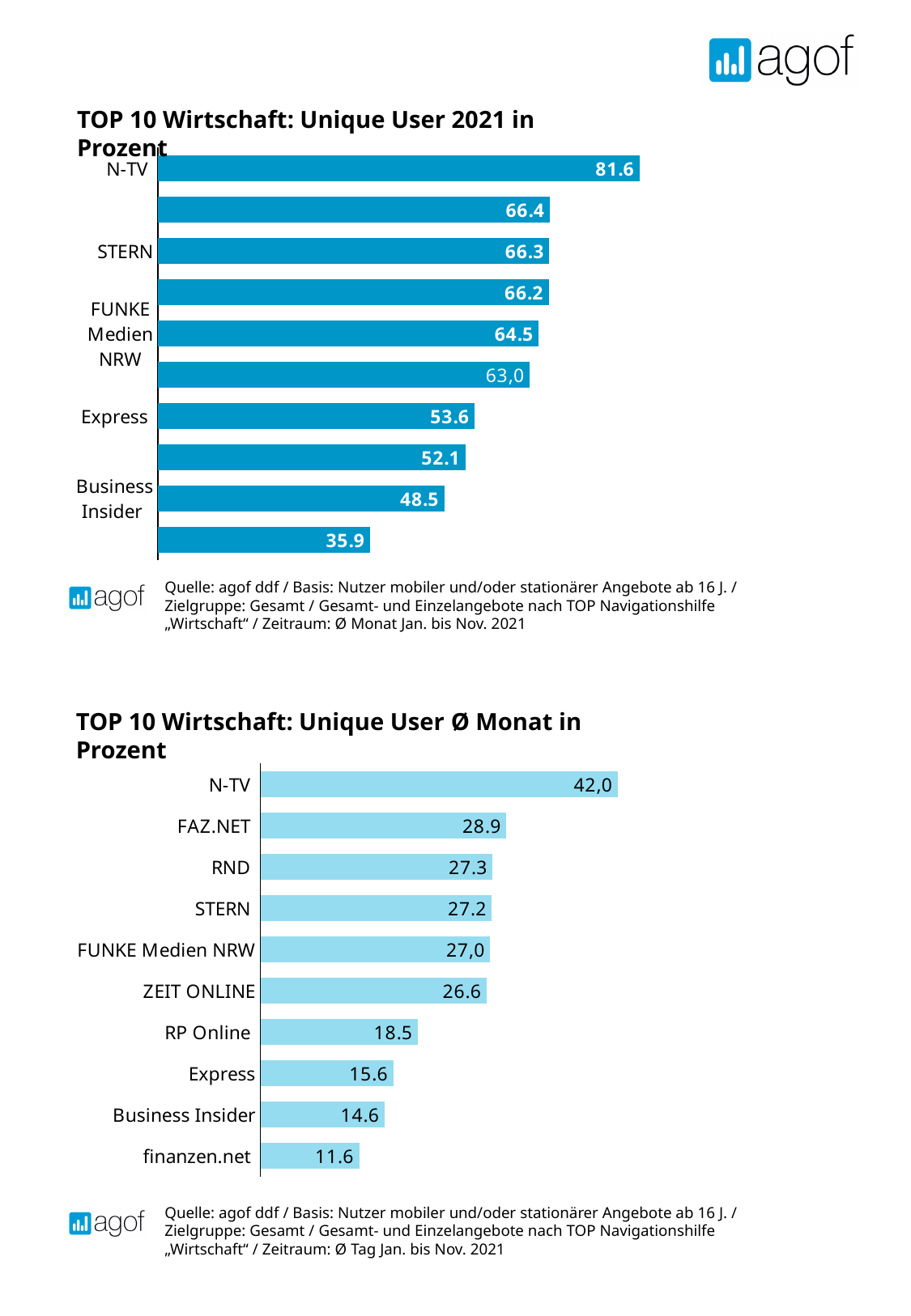
In the chart 'TOP 10 Wirtschaft: Unique User Ø Monat in Prozent', what is the difference between the values for N-TV and FAZ.NET? 13.1 In the chart 'TOP 10 Wirtschaft: Unique User 2021 in Prozent', what is the value for STERN? 66.3 In the chart 'TOP 10 Wirtschaft: Unique User 2021 in Prozent', what is the difference between the values for N-TV and Express? 28.0 In the chart 'TOP 10 Wirtschaft: Unique User Ø Monat in Prozent', what is the value for ZEIT ONLINE? 26.6 In the chart 'TOP 10 Wirtschaft: Unique User Ø Monat in Prozent', which category has the highest value? N-TV In the chart 'TOP 10 Wirtschaft: Unique User Ø Monat in Prozent', which category has the lowest value? finanzen.net In the chart 'TOP 10 Wirtschaft: Unique User 2021 in Prozent', how many bars are plotted? 10 What kind of chart is 'TOP 10 Wirtschaft: Unique User Ø Monat in Prozent'? Bar chart In the chart 'TOP 10 Wirtschaft: Unique User 2021 in Prozent', what is the value for N-TV? 81.6 In the chart 'TOP 10 Wirtschaft: Unique User 2021 in Prozent', what is the value for Business Insider? 48.5 In the chart 'TOP 10 Wirtschaft: Unique User Ø Monat in Prozent', what is the value for FAZ.NET? 28.9 In the chart 'TOP 10 Wirtschaft: Unique User Ø Monat in Prozent', which is larger, the value for RP Online or the value for Express? RP Online